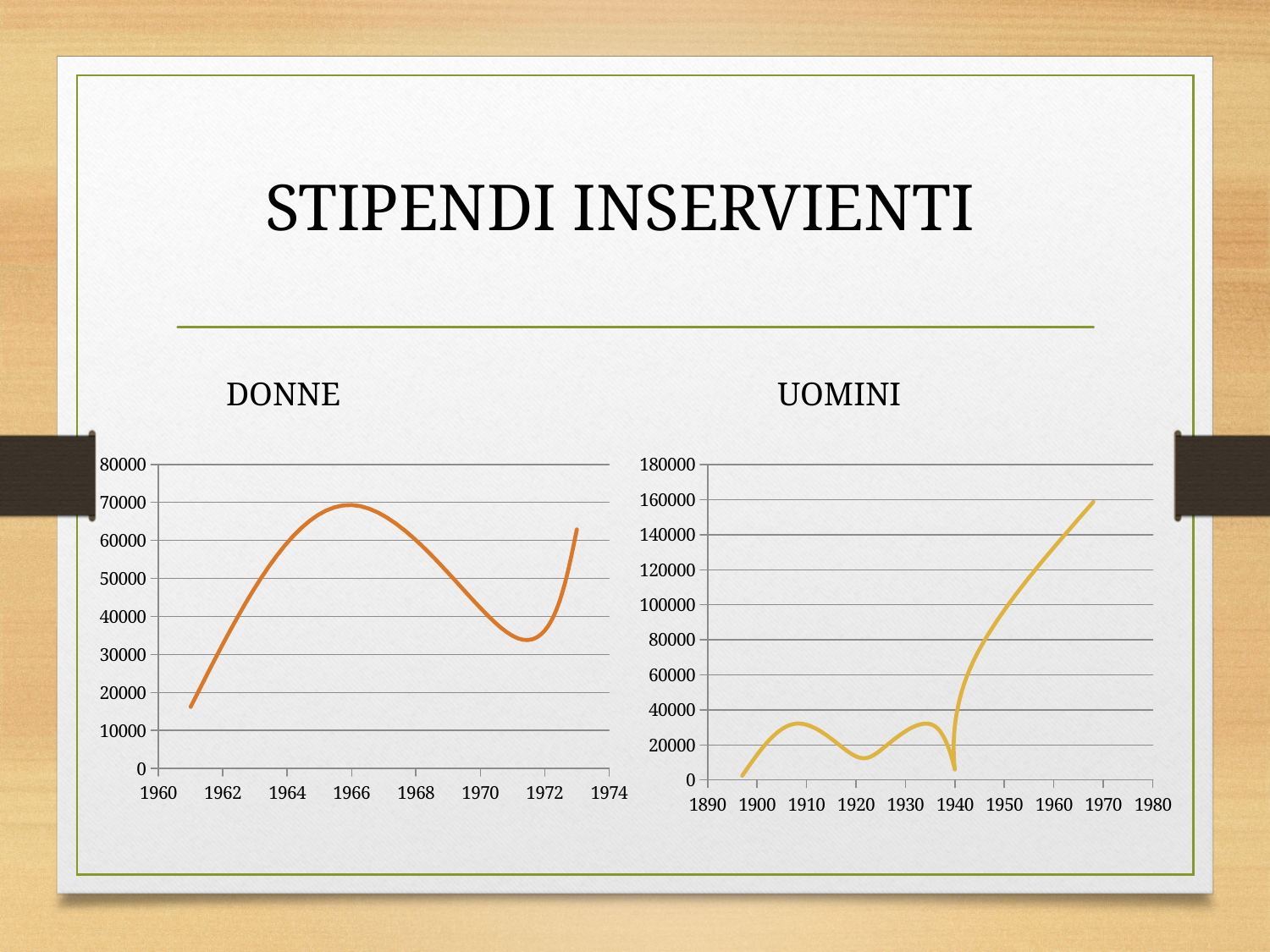
In the DONNE chart, is the value for 1964 greater or less than 50000? greater In the UOMINI chart, is the value for 1940 greater or less than 20000? less In the DONNE chart, does the line rise or fall between 1966 and 1971? fall What kind of chart is the UOMINI chart? line chart In the DONNE chart, around which year does the line reach its highest point? 1966 In the DONNE chart, is the value for 1961 greater or less than 20000? less What kind of chart is the DONNE chart? line chart In the UOMINI chart, does the line rise or fall between 1940 and 1970? rise How many charts are shown on the slide? 2 What are the titles of the two charts on the slide? DONNE and UOMINI In the UOMINI chart, which is larger, the value for 1910 or the value for 1960? 1960